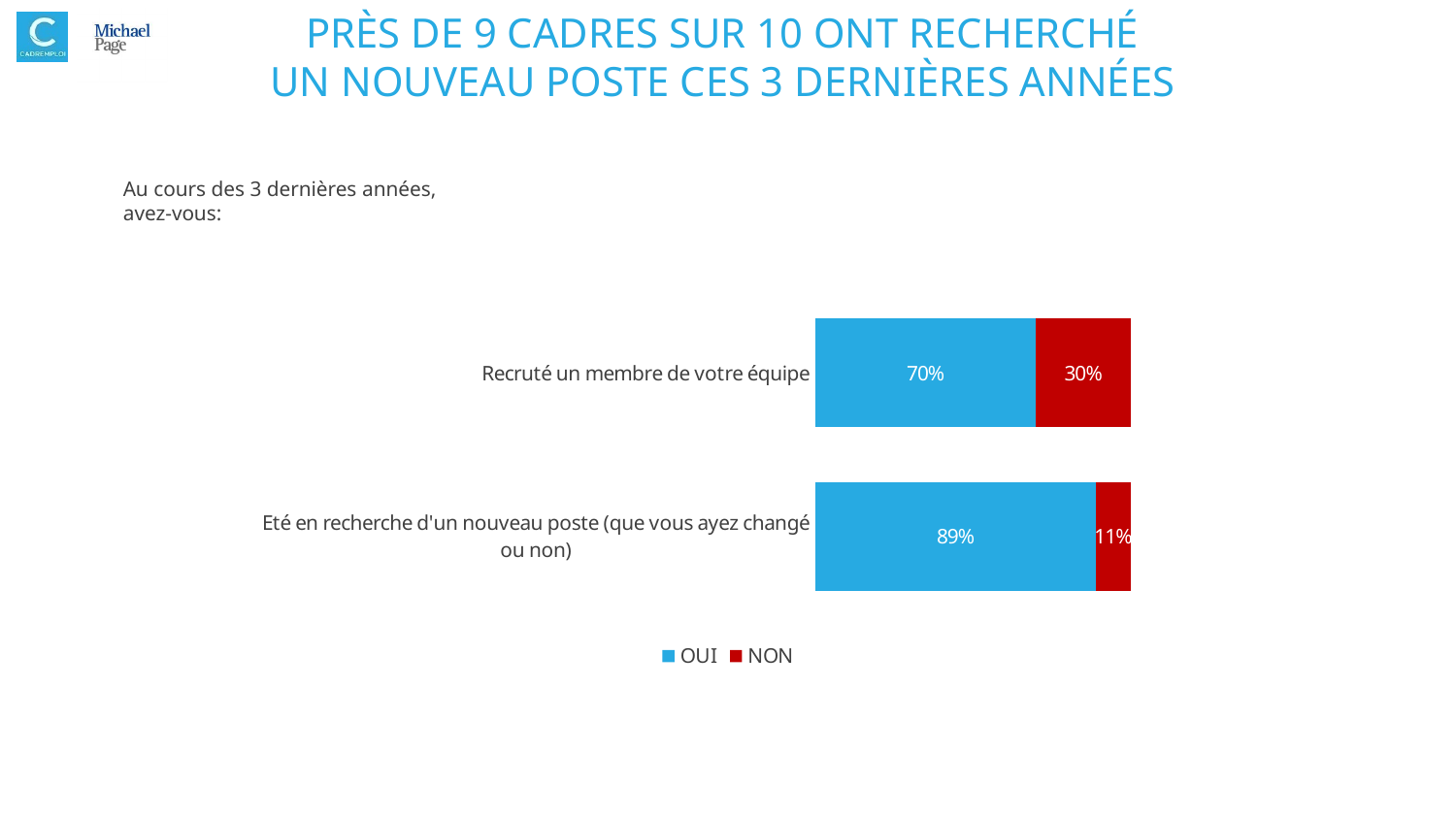
Is the NON share larger for "Recruté un membre de votre équipe" or for "Eté en recherche d'un nouveau poste"? Recruté un membre de votre équipe What percentage of respondents answered NON to "Eté en recherche d'un nouveau poste (que vous ayez changé ou non)"? 11% How many series does the legend list? 2 What percentage of respondents answered OUI to "Eté en recherche d'un nouveau poste (que vous ayez changé ou non)"? 89% Which category has the higher OUI share? Eté en recherche d'un nouveau poste (que vous ayez changé ou non) How many categories are shown in the chart? 2 Which category has the lower NON share? Eté en recherche d'un nouveau poste (que vous ayez changé ou non) What percentage of respondents answered NON to "Recruté un membre de votre équipe"? 30% What type of chart is shown on the slide? Stacked bar chart What percentage of respondents answered OUI to "Recruté un membre de votre équipe"? 70% What is the difference in percentage points between the OUI shares of the two categories? 19 Which colour represents the NON series in the chart? Red